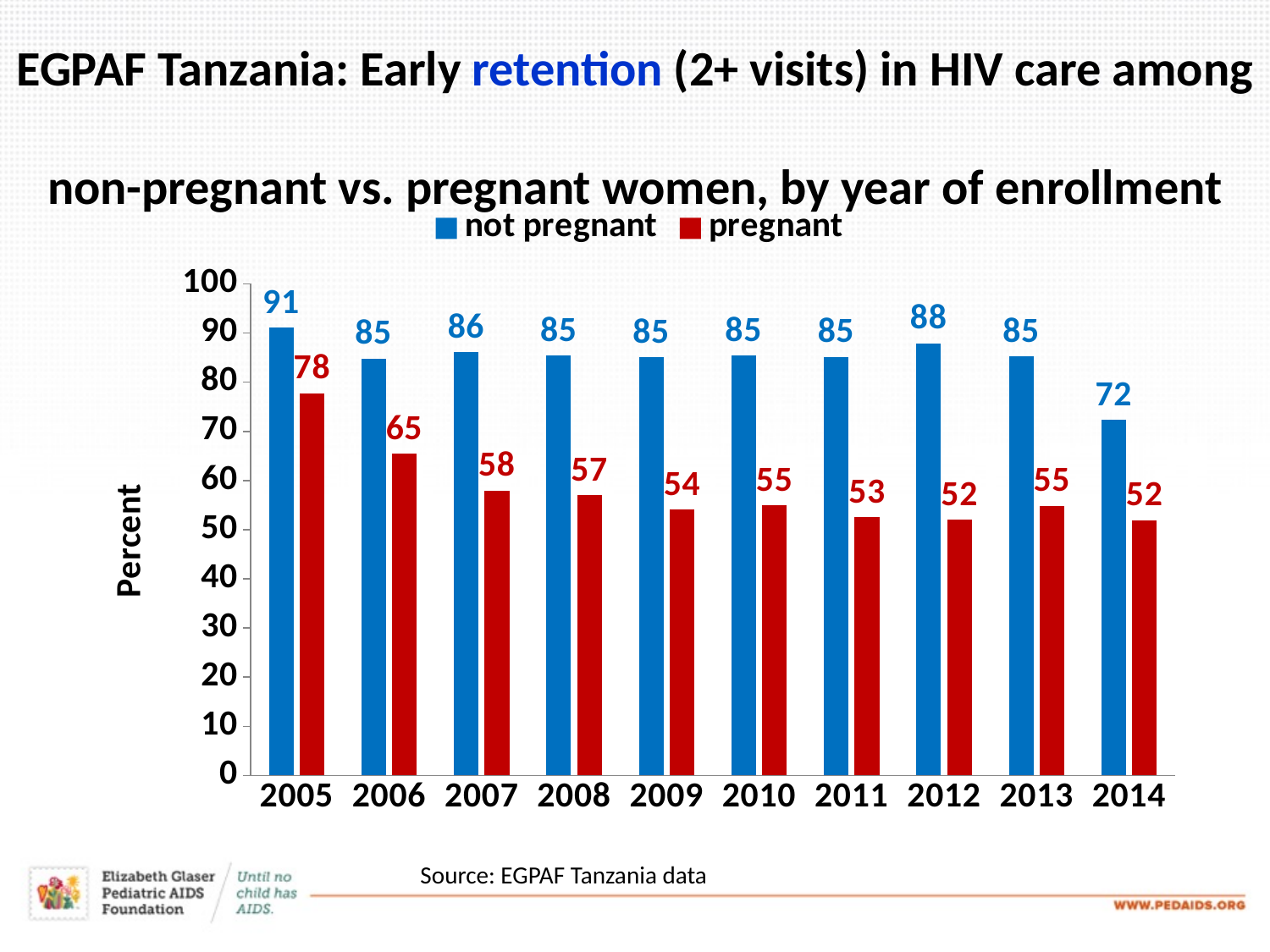
Is the value for pregnant women in 2009 greater or less than 60? less What kind of chart is shown on the slide? bar chart How many years are shown on the x axis? 10 What is the difference between the not pregnant and pregnant values in 2012? 36 Which year has the lowest value for not pregnant women? 2014 What is the value for pregnant women in 2014? 52 What is the label of the y axis? Percent What is the value for not pregnant women in 2005? 91 What is the value for pregnant women in 2008? 57 Which year has the highest value for pregnant women? 2005 How many series does the legend list? 2 Which is larger in 2006: the value for not pregnant women or for pregnant women? not pregnant